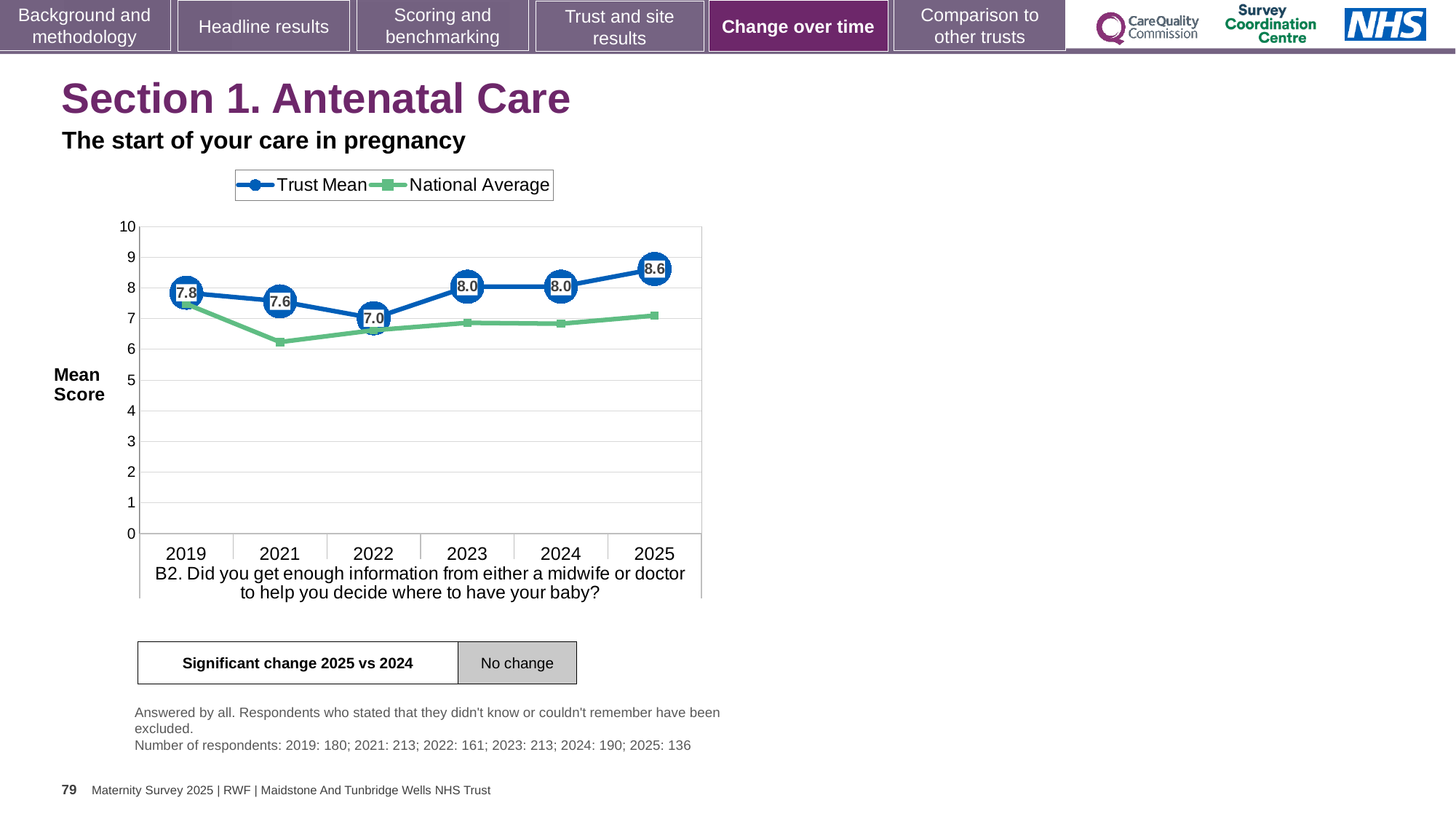
What is the Trust Mean value for 2019? 7.8 What is the Trust Mean value for 2025? 8.6 In which year is the Trust Mean lowest? 2022 What is the difference between the Trust Mean in 2025 and in 2024? 0.6 How many years are shown on the x axis? 6 Which is larger, the Trust Mean in 2019 or in 2021? 2019 In which year is the Trust Mean highest? 2025 What is the Trust Mean value for 2022? 7.0 How many series does the legend list? 2 What kind of chart is shown on the slide? Line chart Is the National Average value for 2021 greater or less than 7? less